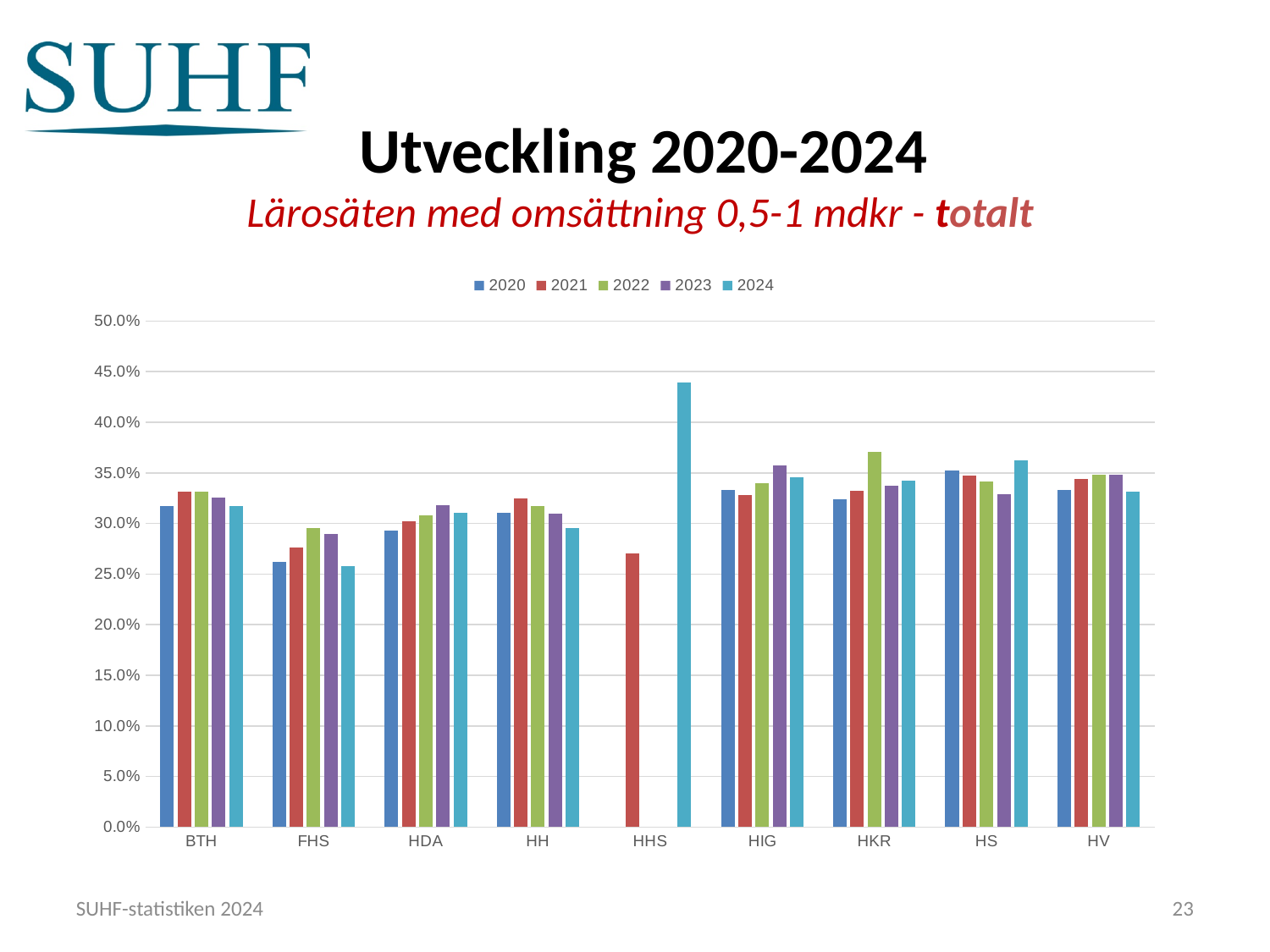
Is the 2024 value for HHS greater or less than 40.0%? greater For HH, do the values rise or fall from 2021 to 2024? fall For HS, which is larger: the 2023 value or the 2024 value? 2024 Which category has the single highest bar in the chart? HHS What kind of chart is shown on the slide? bar chart Is the 2021 value for HHS greater or less than 30.0%? less Which category has bars for only two of the five years? HHS Is the 2022 value for HKR greater or less than 35.0%? greater How many series does the legend list? 5 How many categories (lärosäten) are shown on the x axis? 9 For HKR, which is larger: the 2020 value or the 2022 value? 2022